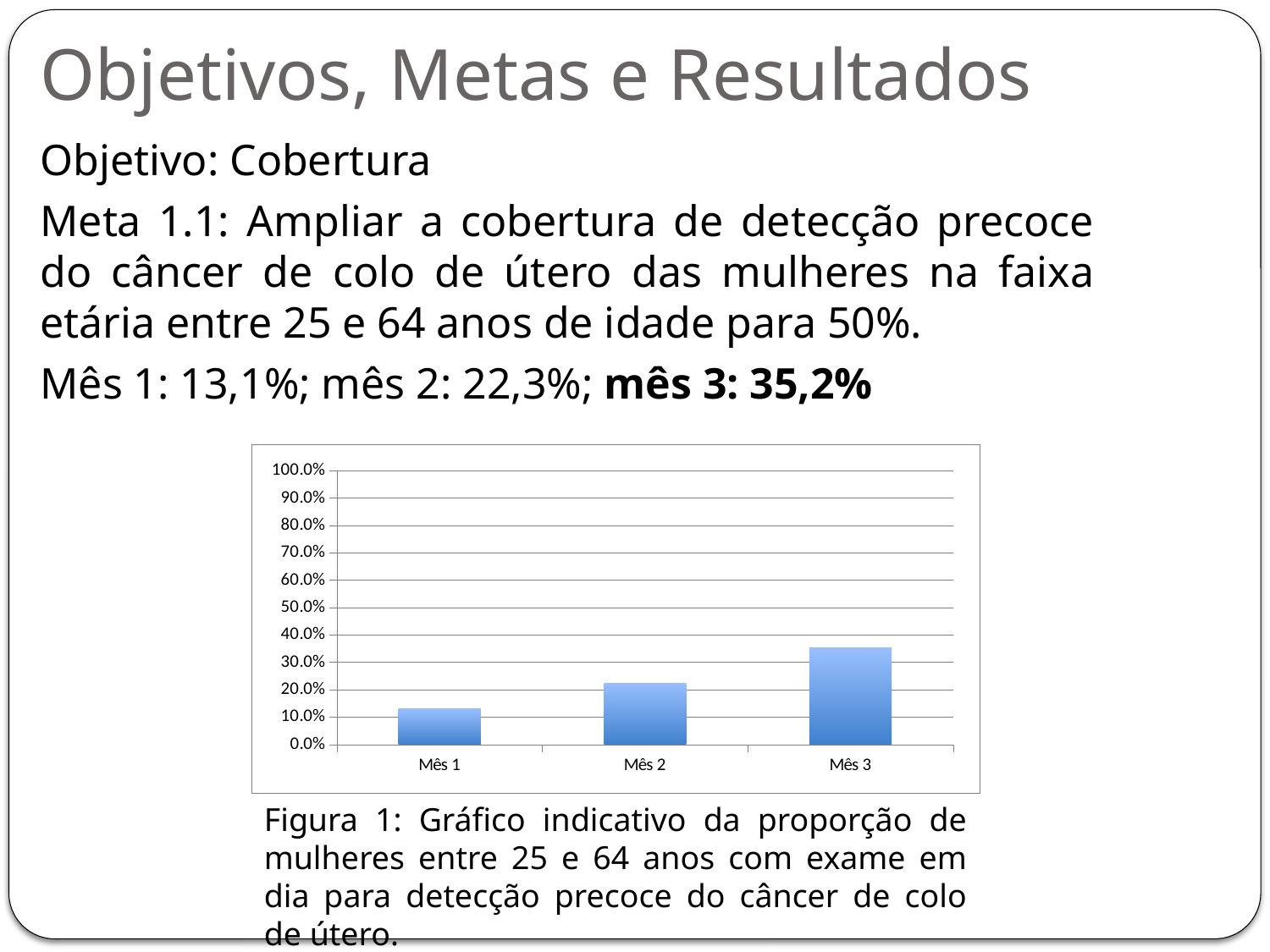
Is the value for Mês 3 greater or less than 30.0%? greater Do the values rise or fall from Mês 1 to Mês 3? rise Is the value for Mês 2 greater or less than 20.0%? greater What kind of chart is shown on the slide? bar chart How many categories (months) are plotted on the chart? 3 What is the maximum value shown on the chart's vertical axis? 100.0% According to the slide text, what is the coverage value for mês 3? 35,2% Is the value for Mês 1 greater or less than 20.0%? less Which month has the lowest bar on the chart? Mês 1 Which month has the highest bar on the chart? Mês 3 Which is larger, the value for Mês 2 or the value for Mês 3? Mês 3